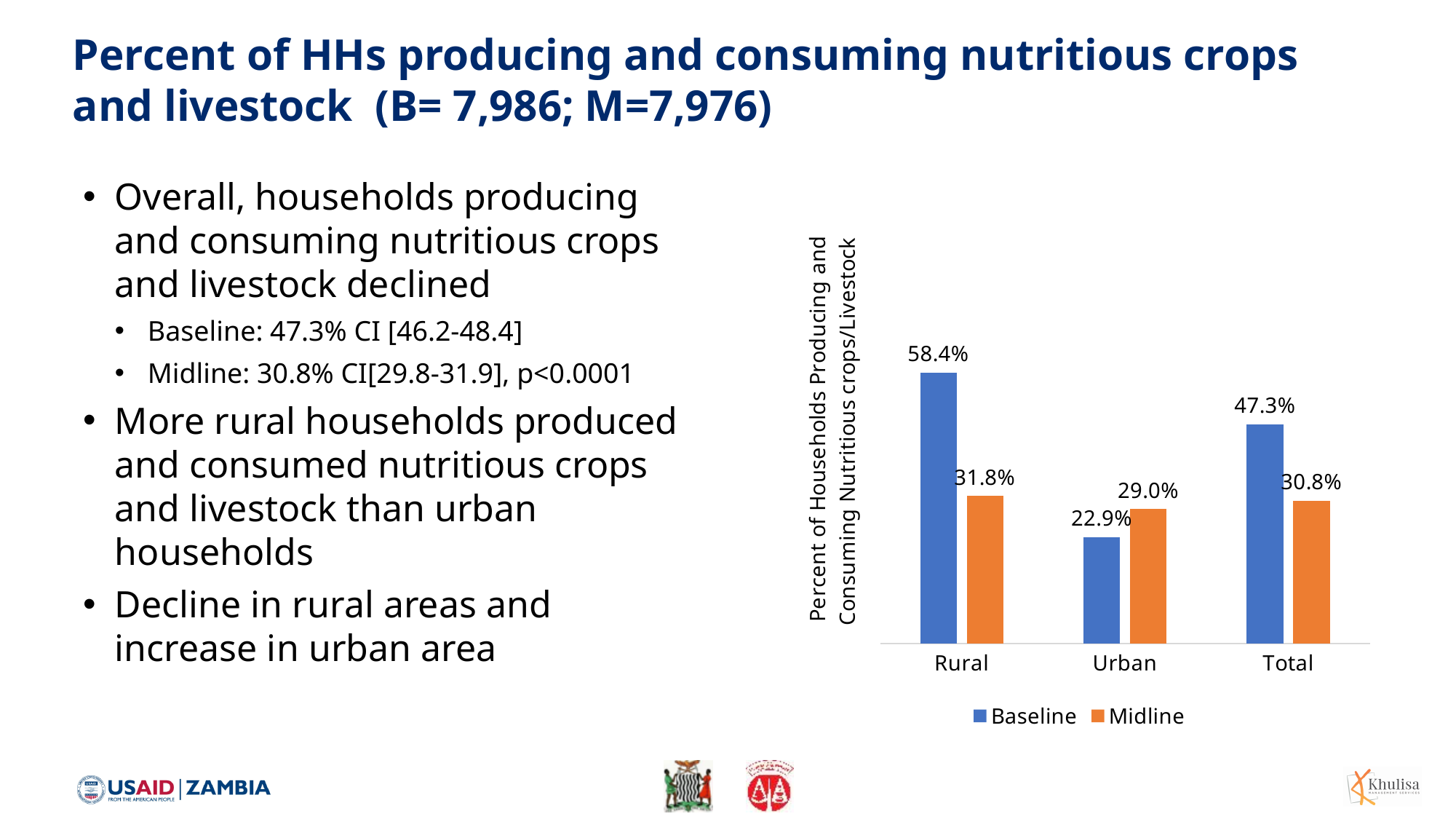
What is the difference between the Baseline and Midline values for Rural? 26.6% Which colour represents the Midline series? Orange How many categories are shown on the x axis? 3 Which is larger for Urban, the Baseline value or the Midline value? Midline What is the Baseline value for Rural? 58.4% What is the difference between the Midline values for Rural and Urban? 2.8% What kind of chart is shown on the slide? Bar chart What is the Midline value for Total? 30.8% Which category has the lowest Baseline value? Urban How many series does the legend list? 2 Which category has the highest Baseline value? Rural What is the Midline value for Urban? 29.0%